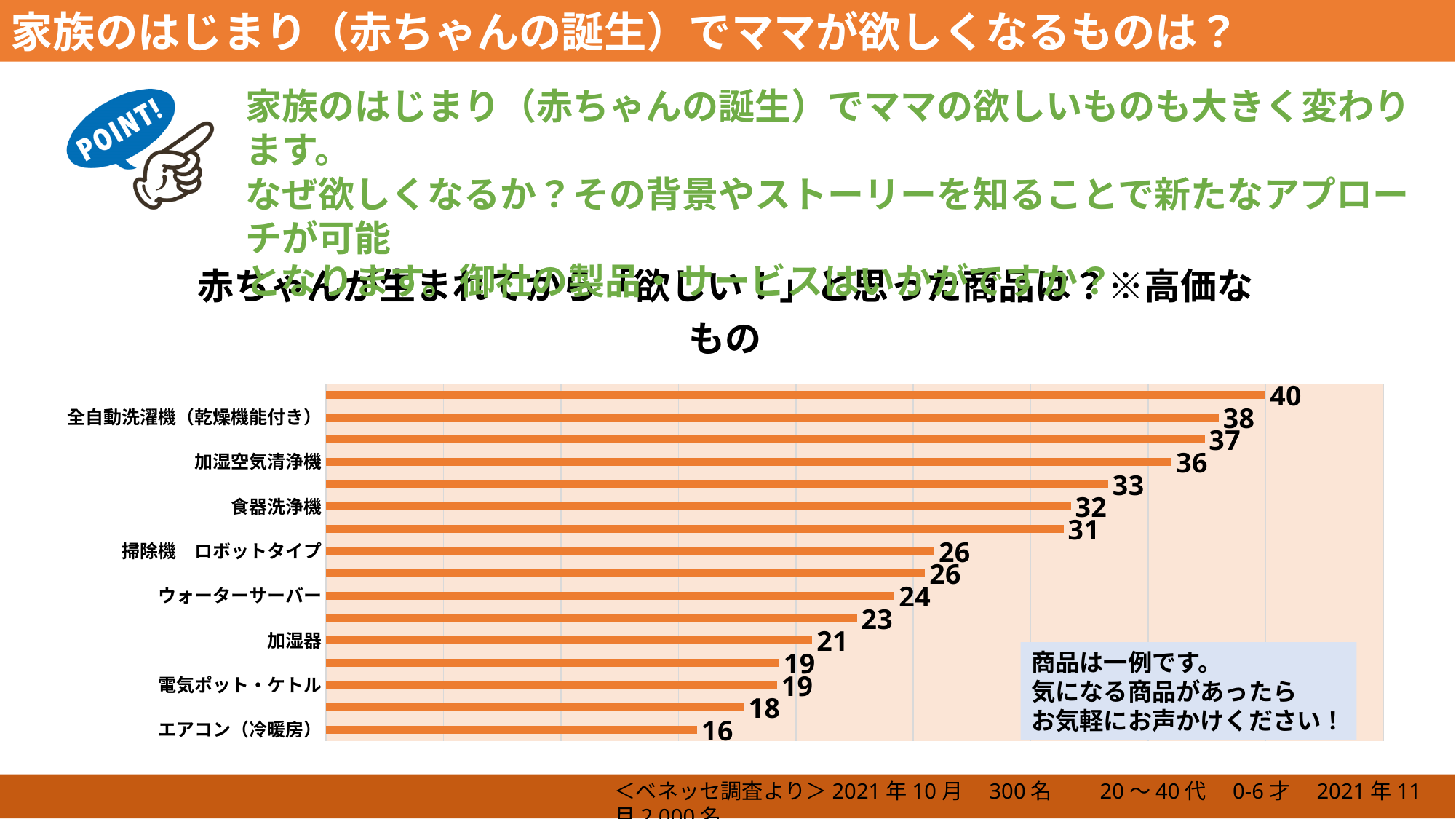
What is the value for ウォーターサーバー? 24 What is the value for 加湿空気清浄機? 36 What is the value for 食器洗浄機? 32 What is the highest value shown in the chart? 40 Do the bar values increase or decrease going from the top of the chart to the bottom? decrease What is the value for エアコン（冷暖房）? 16 What kind of chart is shown on the slide? bar chart What is the difference between the values for 全自動洗濯機（乾燥機能付き） and エアコン（冷暖房）? 22 Which labeled category has the lowest value? エアコン（冷暖房） Which is larger, the value for 加湿空気清浄機 or the value for 食器洗浄機? 加湿空気清浄機 What is the value for 全自動洗濯機（乾燥機能付き）? 38 How many bars are plotted in the chart? 16